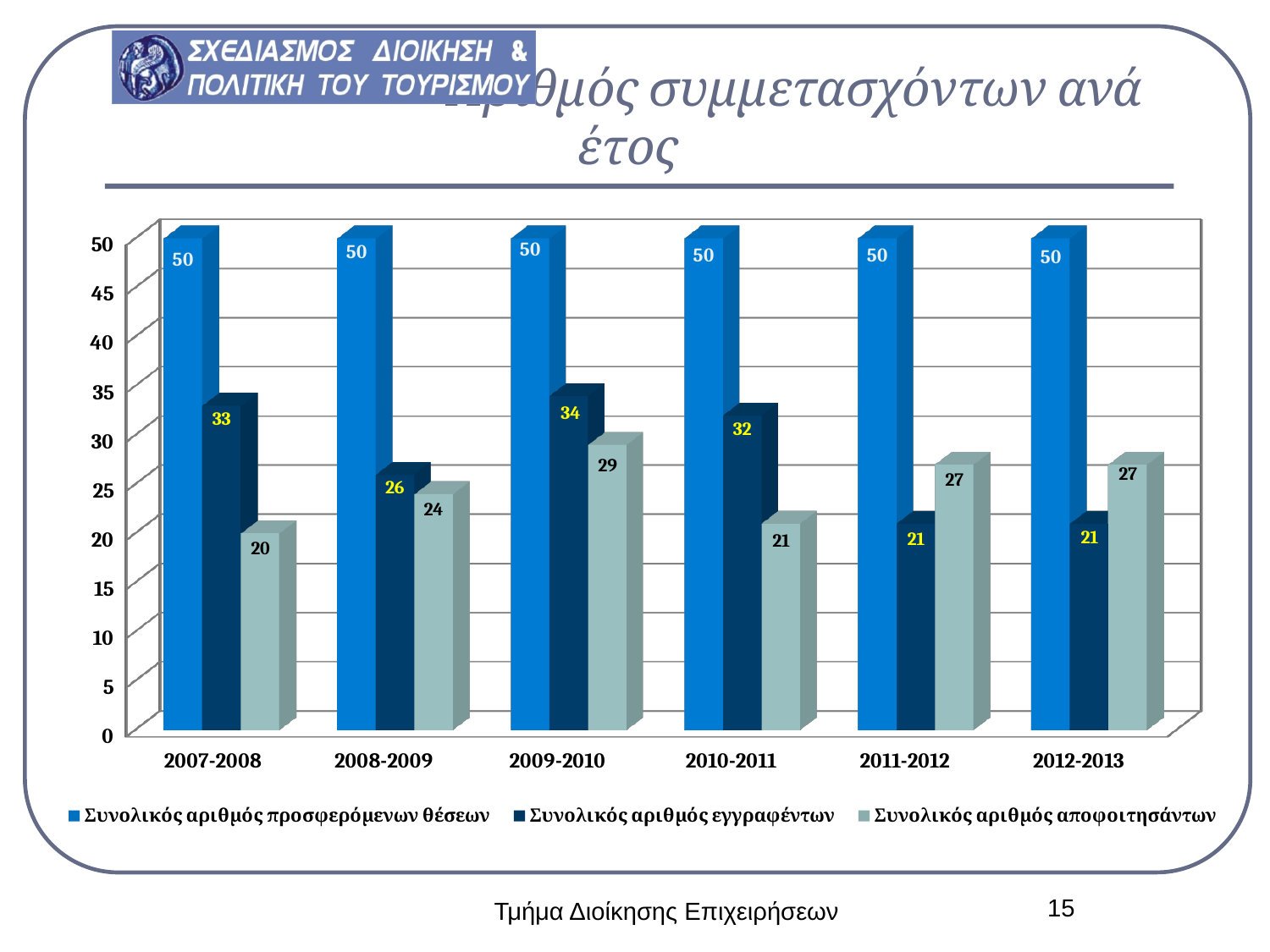
What is the value of Συνολικός αριθμός προσφερόμενων θέσεων for 2011-2012? 50 What is the value of Συνολικός αριθμός εγγραφέντων for 2009-2010? 34 What is the value of Συνολικός αριθμός αποφοιτησάντων for 2007-2008? 20 Does Συνολικός αριθμός προσφερόμενων θέσεων rise, fall or stay the same across the years? Stays the same In which year is Συνολικός αριθμός αποφοιτησάντων lowest? 2007-2008 Which is larger in 2011-2012: Συνολικός αριθμός εγγραφέντων or Συνολικός αριθμός αποφοιτησάντων? Συνολικός αριθμός αποφοιτησάντων In which year is Συνολικός αριθμός εγγραφέντων highest? 2009-2010 How many series does the legend list? 3 How many years are shown on the x axis? 6 What is the difference between Συνολικός αριθμός εγγραφέντων and Συνολικός αριθμός αποφοιτησάντων in 2007-2008? 13 Is the value of Συνολικός αριθμός αποφοιτησάντων for 2009-2010 greater or less than 25? greater What kind of chart is shown on the slide? Bar chart